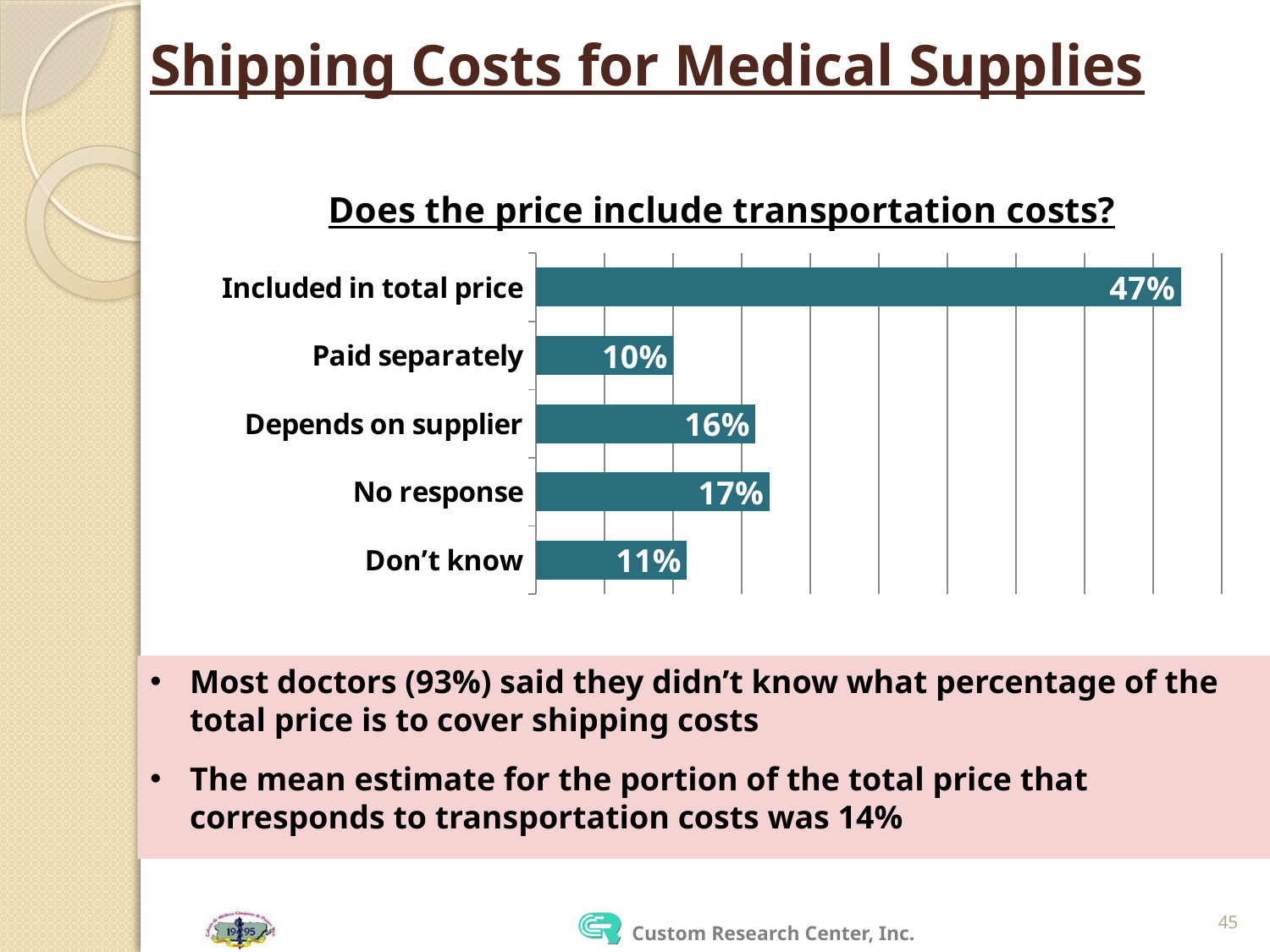
How many categories are shown in the chart? 5 What is the difference between 'Included in total price' and 'No response'? 30% What is the value for 'Paid separately'? 10% What is the title of the chart? Does the price include transportation costs? What percentage of respondents said transportation costs are included in the total price? 47% What is the value for 'Don't know'? 11% Which category has the lowest value? Paid separately Which is larger, 'Depends on supplier' or 'Don't know'? Depends on supplier What is the value for 'Depends on supplier'? 16% What is the value for 'No response'? 17% What kind of chart is shown on the slide? Bar chart Which category has the highest value? Included in total price